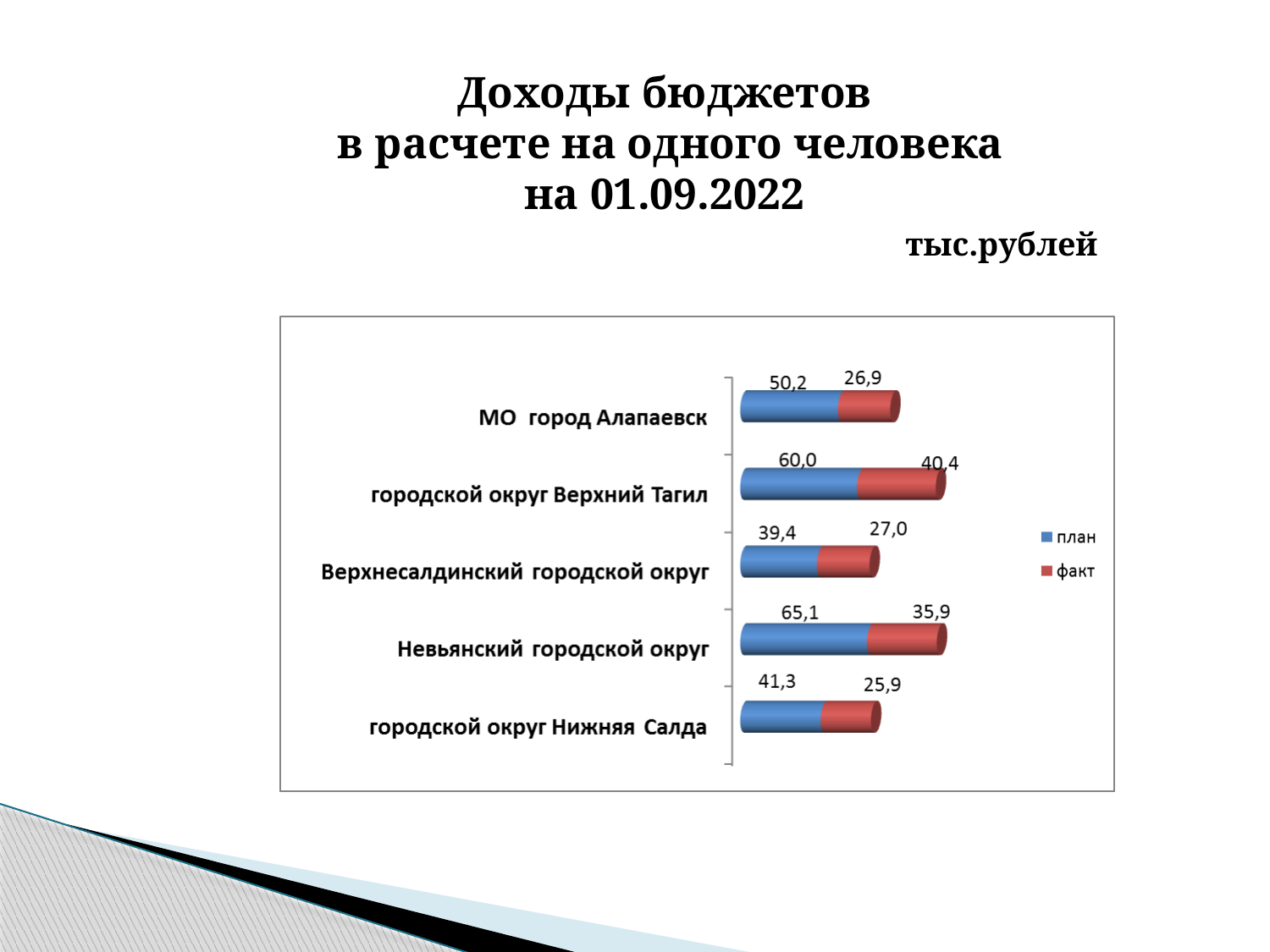
What is the план value for Невьянский городской округ? 65,1 How many categories are shown in the chart? 5 What is the факт value for городской округ Нижняя Салда? 25,9 Which category has the highest план value? Невьянский городской округ What kind of chart is shown on the slide? Bar chart What is the difference between the план and факт values for МО город Алапаевск? 23,3 Which is larger: the факт value for Верхнесалдинский городской округ or the факт value for МО город Алапаевск? Верхнесалдинский городской округ What is the total of the stacked bar for городской округ Верхний Тагил? 100,4 Which category has the highest факт value? городской округ Верхний Тагил How many series does the legend list? 2 What is the факт value for городской округ Верхний Тагил? 40,4 Which category has the lowest план value? Верхнесалдинский городской округ